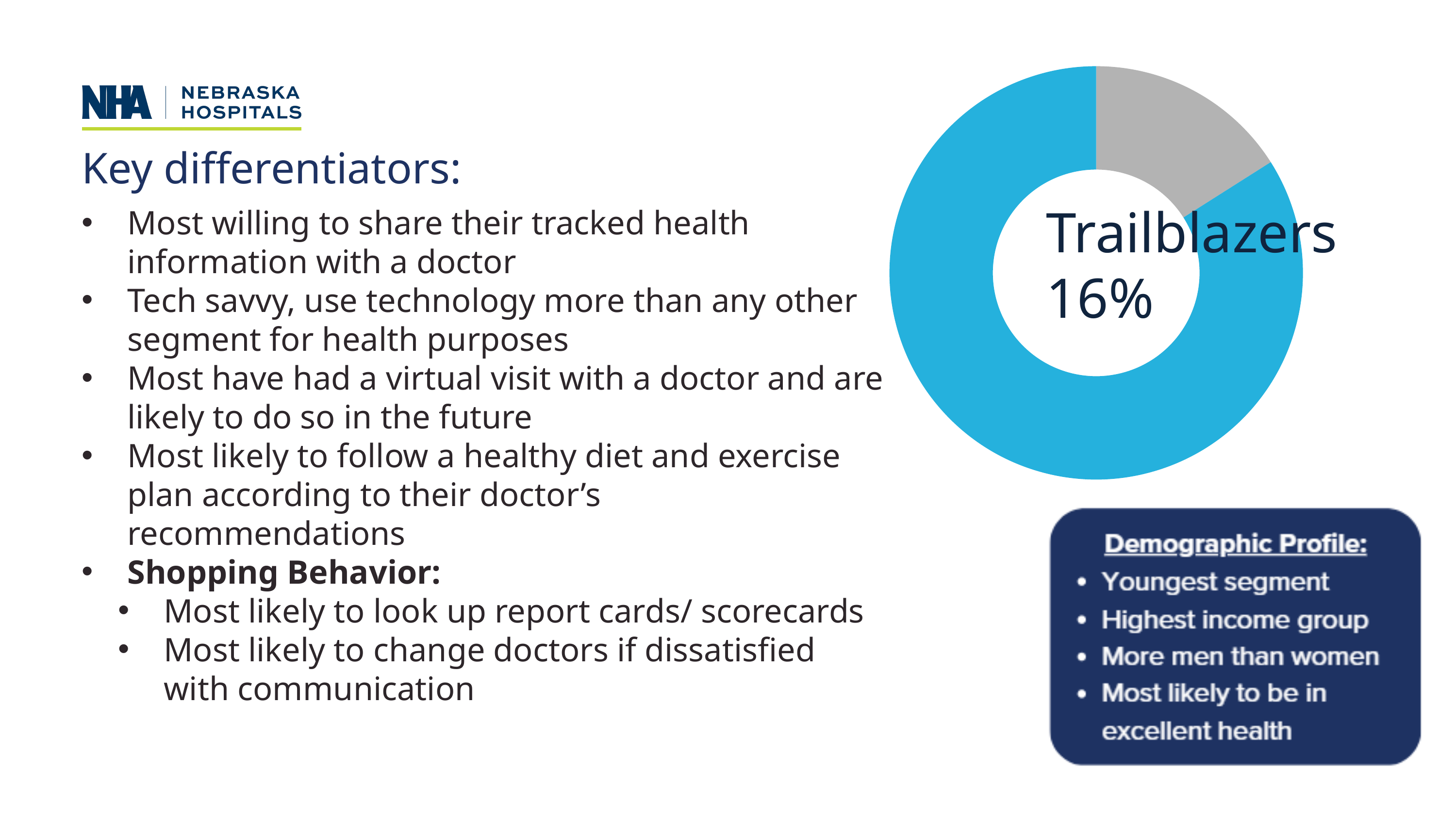
What colour is the smaller segment of the donut chart? Grey How many segments does the donut chart have? 2 What kind of chart is shown on the slide? Donut (pie) chart Which segment of the donut chart is larger, the blue one or the grey one? The blue one What percentage is shown for Trailblazers in the donut chart? 16% What label is printed in the centre of the donut chart? Trailblazers 16%